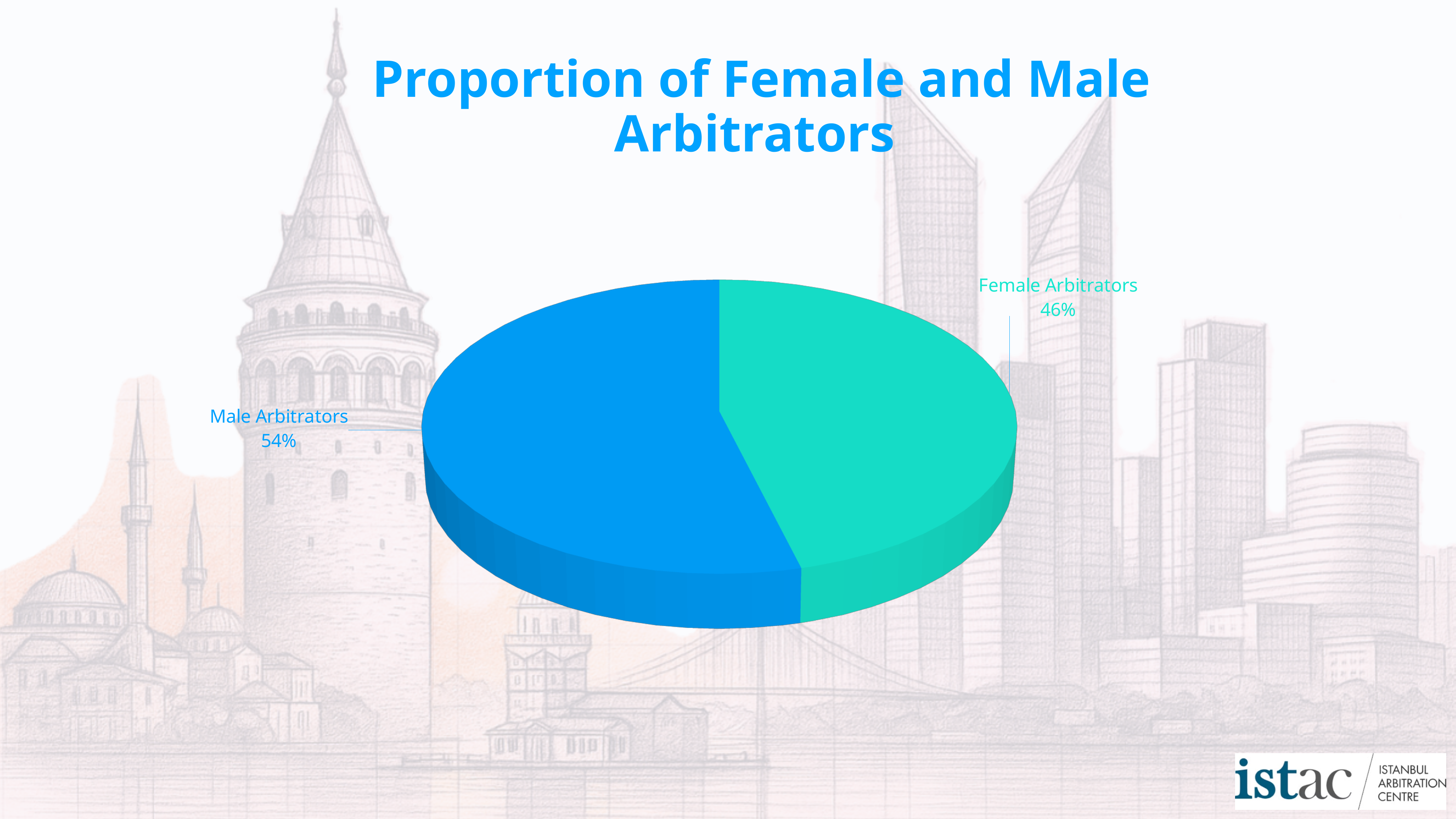
What percentage of arbitrators are male according to the pie chart? 54% How many slices does the pie chart have? 2 What percentage of arbitrators are female according to the pie chart? 46% What is the title of the chart? Proportion of Female and Male Arbitrators What is the difference in percentage points between Male Arbitrators and Female Arbitrators? 8 What colour is the Female Arbitrators slice? teal/green Which category has the larger share of the pie chart? Male Arbitrators What kind of chart is shown on the slide? pie chart Is the share of Male Arbitrators larger or smaller than the share of Female Arbitrators? larger Which category has the smaller share of the pie chart? Female Arbitrators What is the share of the pie represented by Female Arbitrators? 46%